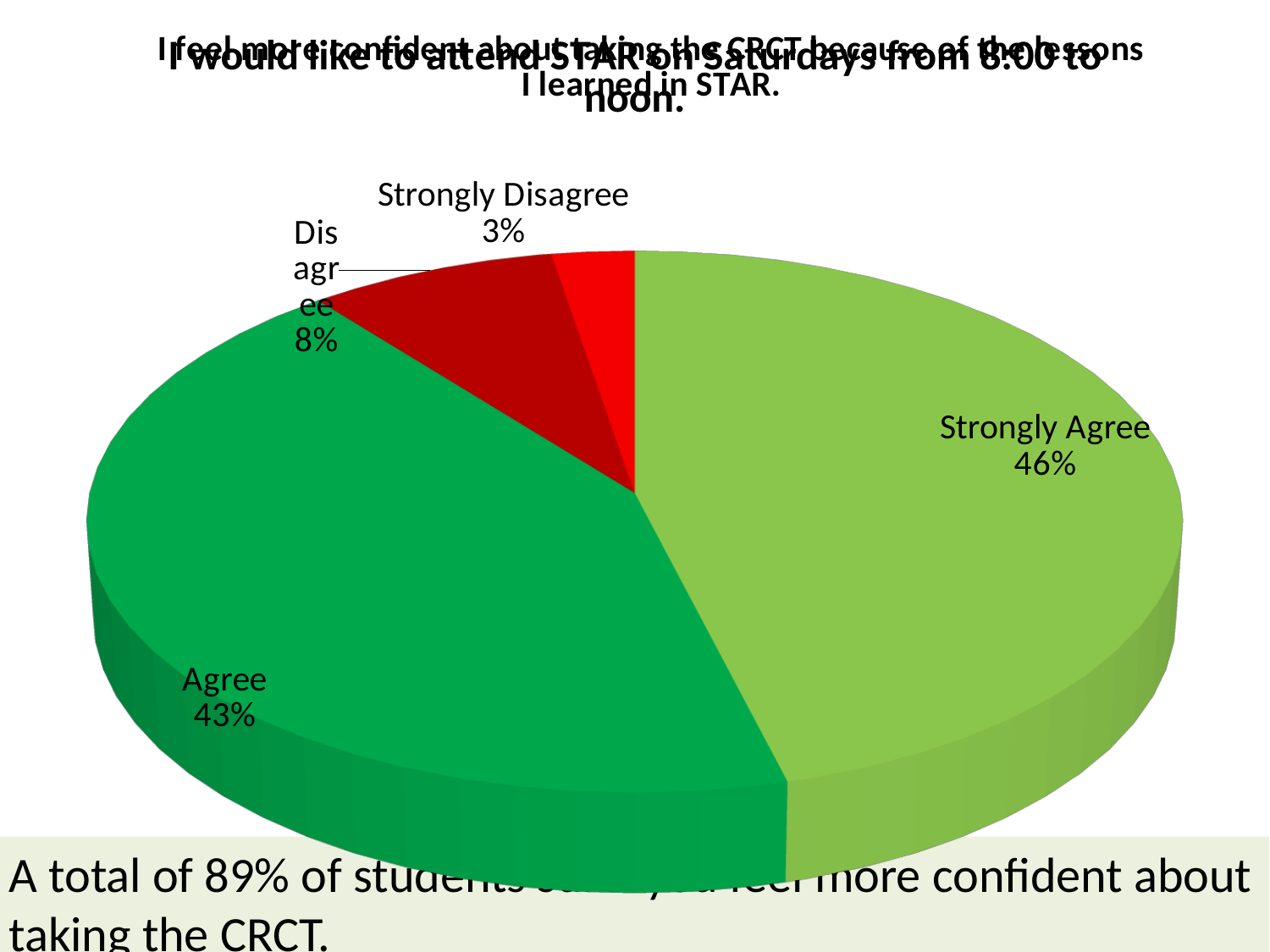
Which slice of the pie is the smallest? Strongly Disagree What is the difference in percentage points between the Disagree and Strongly Disagree slices? 5 How many slices does the pie chart have? 4 What colour is the Strongly Disagree slice? red Which slice of the pie is the largest? Strongly Agree Which slice is larger, Disagree or Strongly Disagree? Disagree What percentage of the pie is the Strongly Disagree slice? 3% What percentage of the pie is the Disagree slice? 8% What percentage of the pie is the Strongly Agree slice? 46% What kind of chart is shown on the slide? pie chart What percentage of the pie is the Agree slice? 43% What is the difference in percentage points between the Strongly Agree and Agree slices? 3